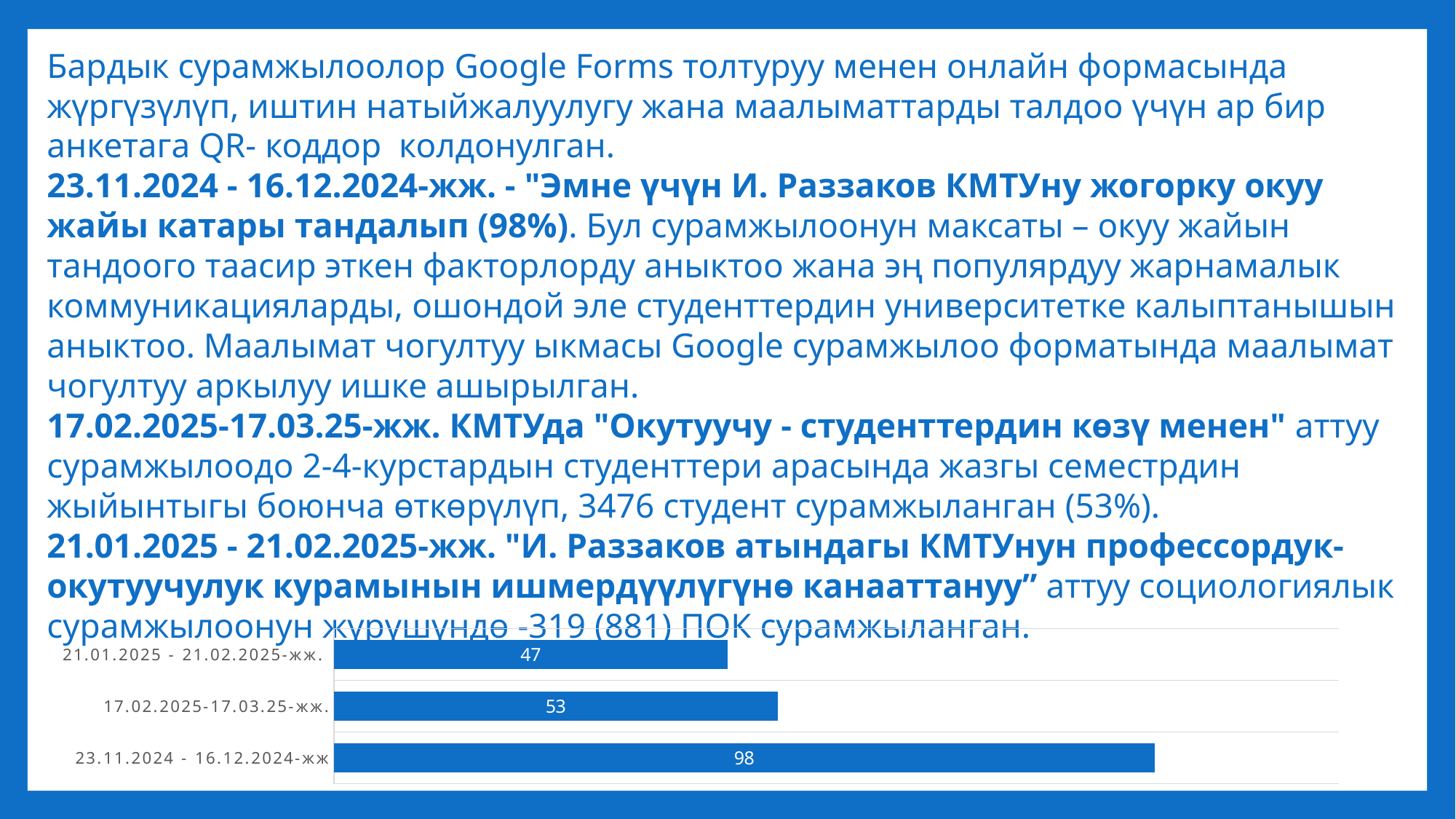
What is the value for the category "23.11.2024 - 16.12.2024-жж"? 98 How many categories are shown in the chart? 3 Are the bars in the chart horizontal or vertical? horizontal What colour are the bars in the chart? blue Which is larger: the value for "17.02.2025-17.03.25-жж." or the value for "21.01.2025 - 21.02.2025-жж."? 17.02.2025-17.03.25-жж. What is the difference between the values for "23.11.2024 - 16.12.2024-жж" and "17.02.2025-17.03.25-жж."? 45 What is the difference between the values for "17.02.2025-17.03.25-жж." and "21.01.2025 - 21.02.2025-жж."? 6 Which category has the highest value? 23.11.2024 - 16.12.2024-жж What is the value for the category "17.02.2025-17.03.25-жж."? 53 Which category has the lowest value? 21.01.2025 - 21.02.2025-жж. What kind of chart is shown on the slide? bar chart What is the value for the category "21.01.2025 - 21.02.2025-жж."? 47